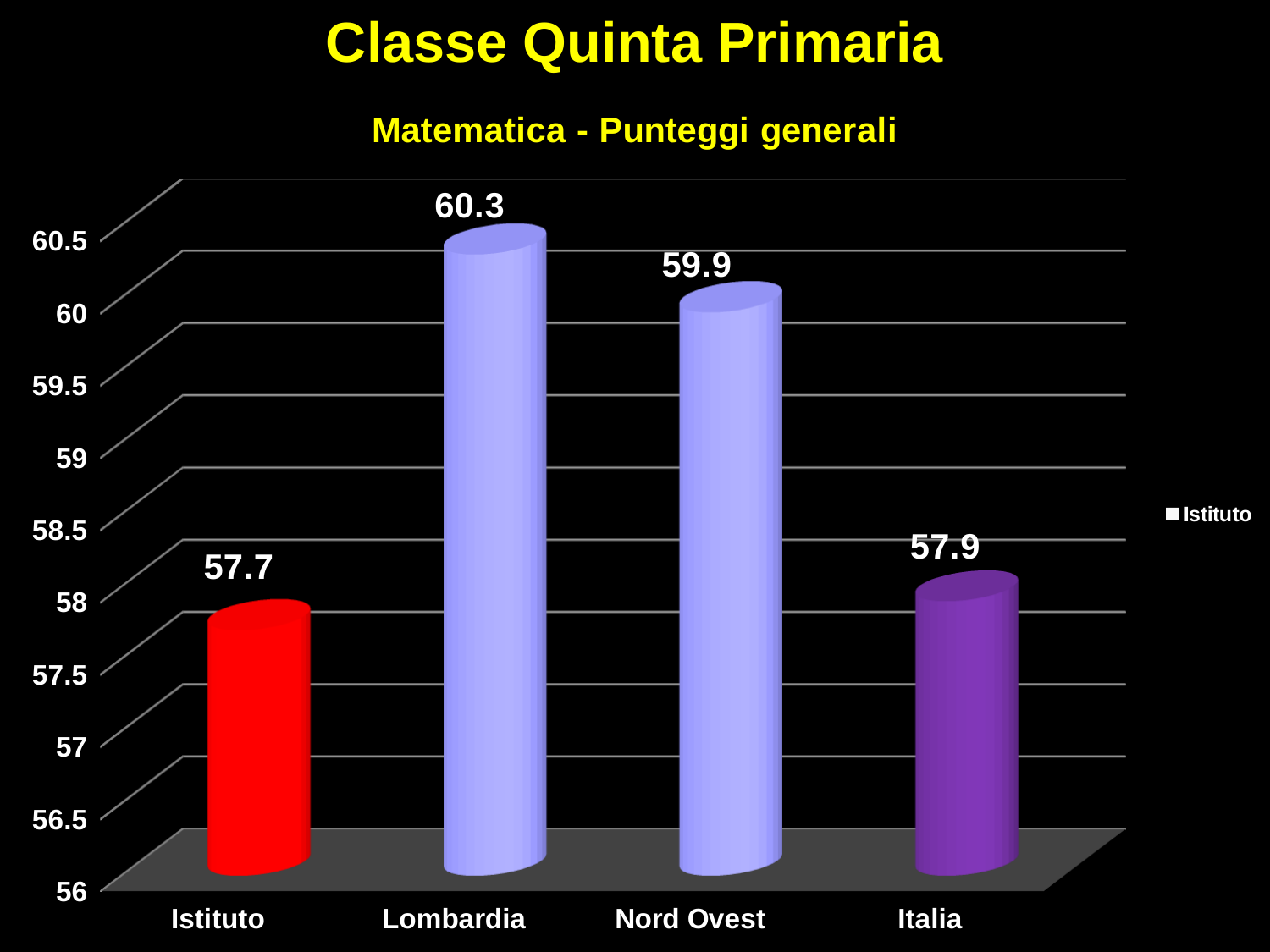
What is the value for Nord Ovest? 59.9 What is the value for Istituto? 57.7 What is the value for Lombardia? 60.3 How many categories are shown on the x axis? 4 Which category has the highest value? Lombardia Which category has the lowest value? Istituto Which is larger, the value for Italia or the value for Istituto? Italia What kind of chart is this? bar chart What is the difference between the values for Lombardia and Istituto? 2.6 What is the difference between the values for Nord Ovest and Italia? 2 What is the chart's title? Matematica - Punteggi generali What is the value for Italia? 57.9